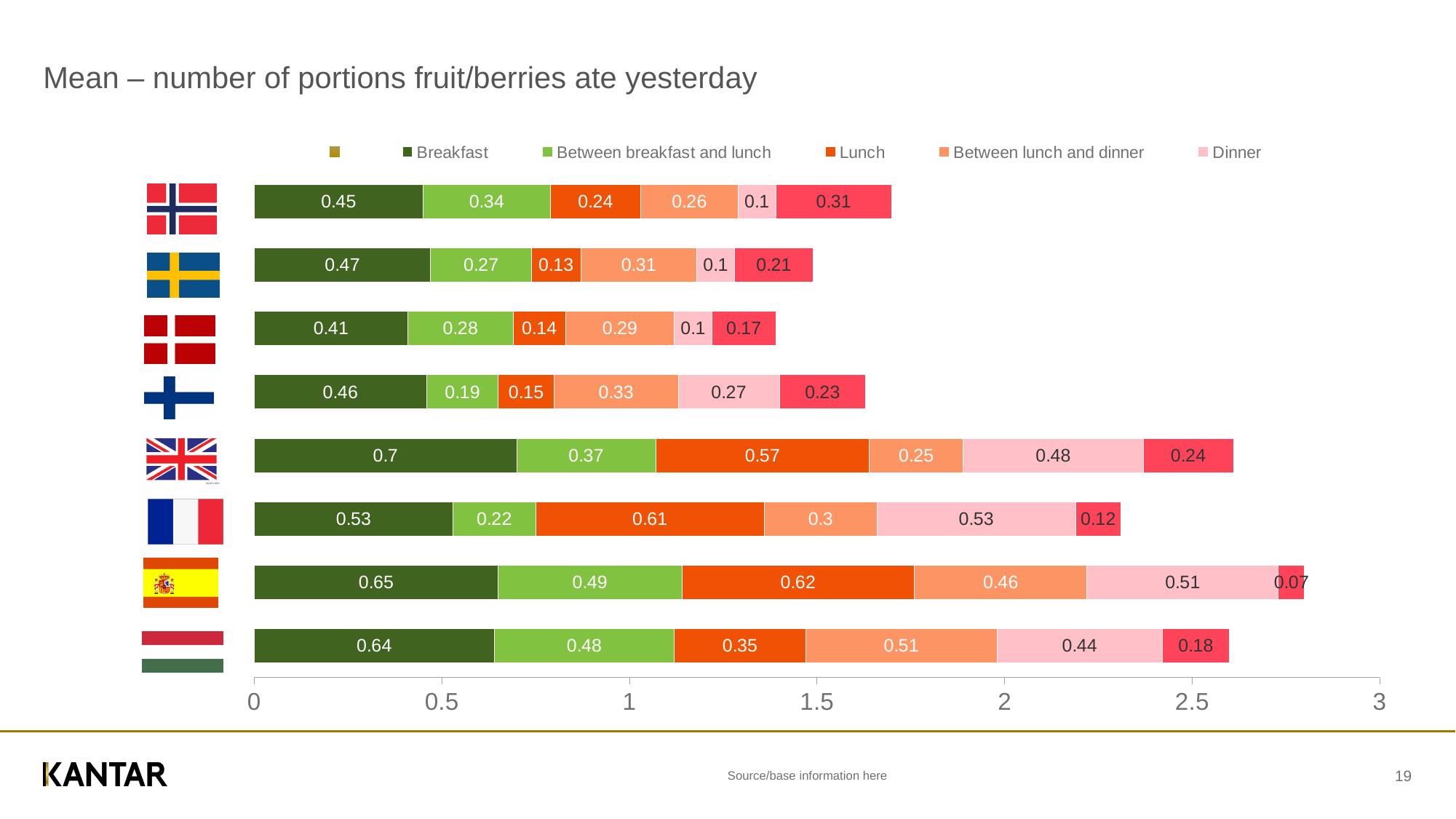
Is the total length of the bar for the Spanish flag row greater or less than 2.5? greater What kind of chart is shown on the slide? Stacked bar chart What is the difference between the Breakfast values of the Spanish flag row (0.65) and the Norwegian flag row (0.45)? 0.2 Which row has the lowest Breakfast value? The Danish flag row (0.41) Which is larger: the Lunch value for the French flag row or the Lunch value for the Finnish flag row? The French flag row (0.61) How many labelled series does the legend list? 5 What is the 'Between lunch and dinner' value for the row with the Hungarian flag (bottom row)? 0.51 What is the Breakfast value for the row with the UK flag (fifth from the top)? 0.7 What is the Lunch value for the row with the Swedish flag (second from the top)? 0.13 Which row has the highest Breakfast value? The UK flag row (0.7) How many country rows (bars) does the chart show? 8 What is the total of the stacked bar for the row with the Norwegian flag (top row)? 1.7